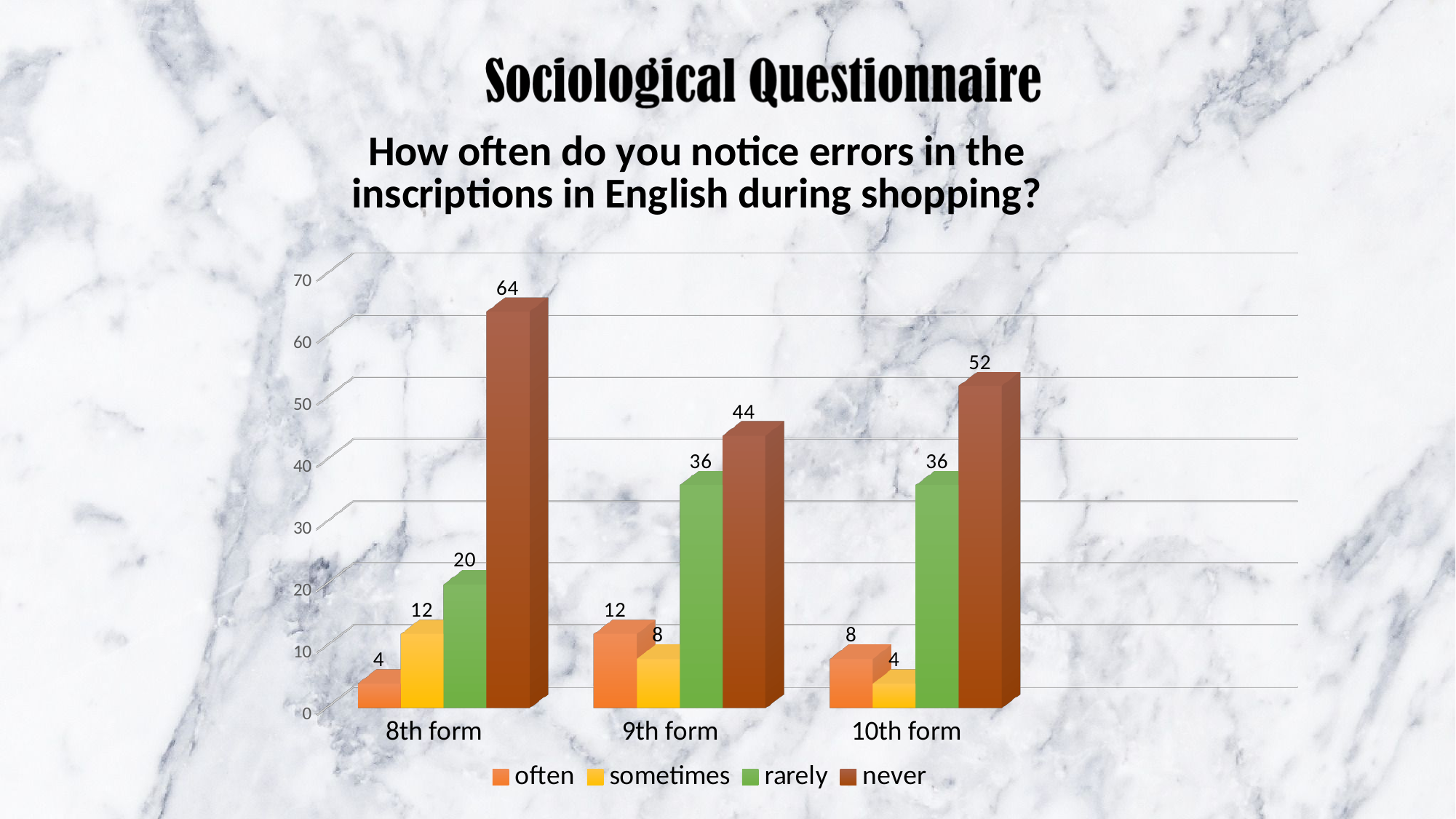
Which form has the highest value for "never"? 8th form Which response has the lowest value in the 8th form? often How many series does the legend list? 4 What is the difference between the "never" values for the 8th form and the 10th form? 12 How many forms (categories) are shown on the x axis? 3 What is the value for "never" in the 8th form? 64 Which is larger: "rarely" in the 8th form or "rarely" in the 9th form? rarely in the 9th form What kind of chart is shown on the slide? bar chart What is the value for "often" in the 10th form? 8 What colour represents the "never" series in the legend? brown What is the value for "sometimes" in the 9th form? 8 What is the value for "rarely" in the 10th form? 36